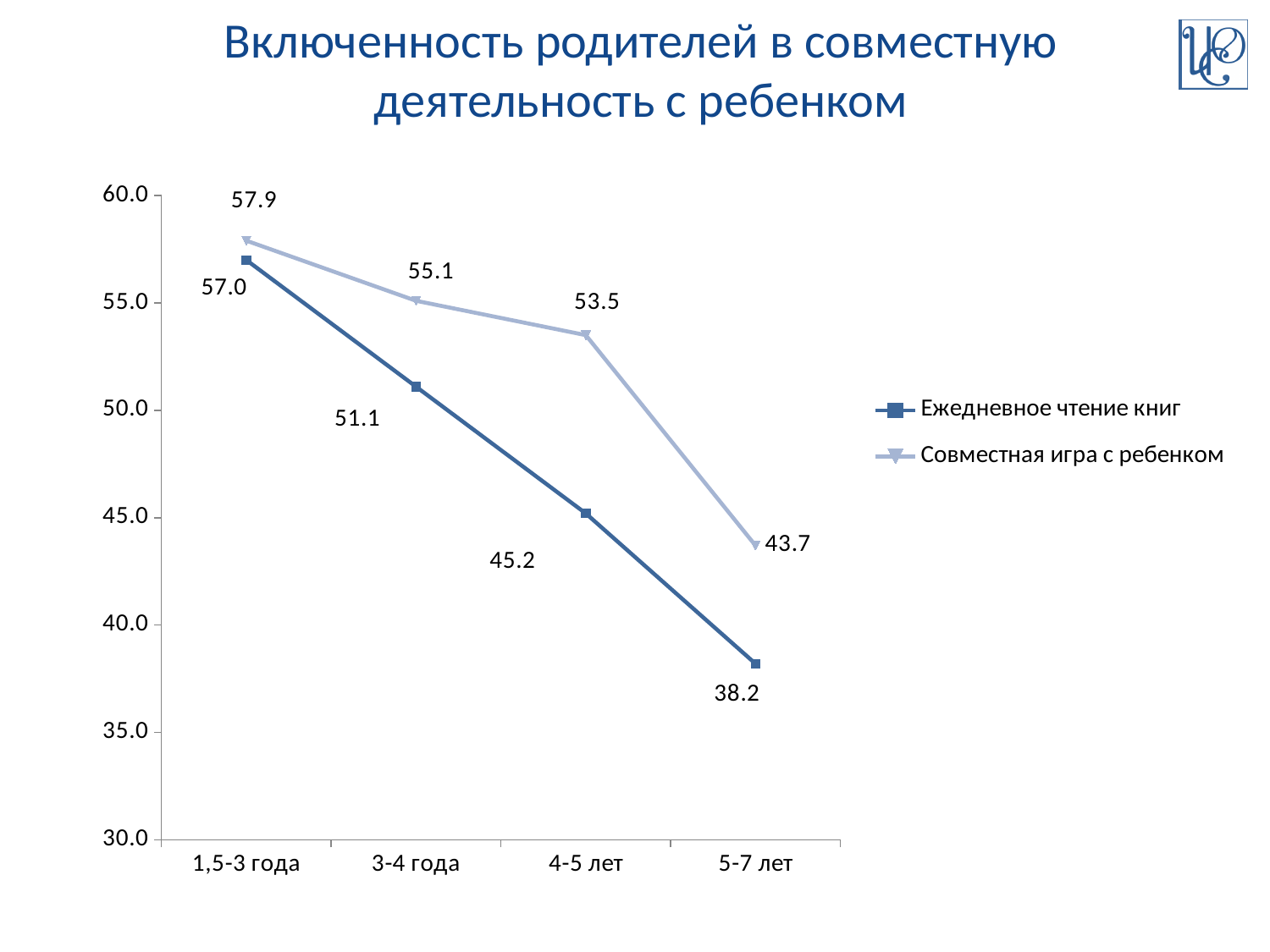
What is the value for 'Ежедневное чтение книг' at '1,5-3 года'? 57.0 What is the difference between 'Совместная игра с ребенком' and 'Ежедневное чтение книг' at '5-7 лет'? 5.5 Which series has the larger value at '4-5 лет'? Совместная игра с ребенком What is the value for 'Совместная игра с ребенком' at '3-4 года'? 55.1 How many age groups are shown on the x axis? 4 For which age group is 'Ежедневное чтение книг' highest? 1,5-3 года What is the value for 'Ежедневное чтение книг' at '5-7 лет'? 38.2 How many series does the legend list? 2 What type of chart is shown on the slide? line chart Do the values for 'Ежедневное чтение книг' rise or fall across the age groups? fall For which age group is 'Совместная игра с ребенком' lowest? 5-7 лет What is the value for 'Совместная игра с ребенком' at '4-5 лет'? 53.5